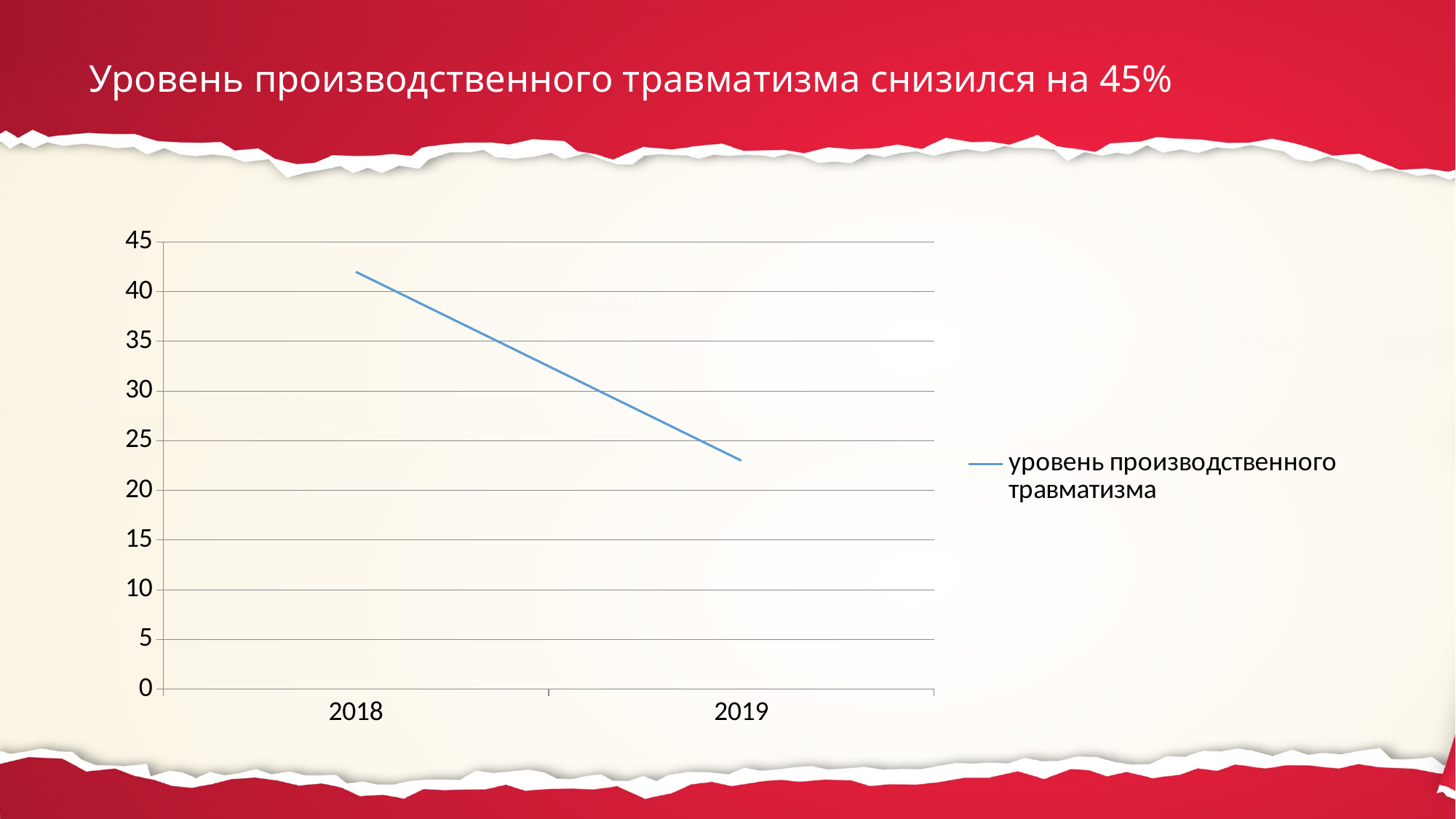
What is the name of the series shown in the legend? уровень производственного травматизма Which year has the highest value on the chart? 2018 Is the value for 2019 greater or less than 30? less What kind of chart is shown on the slide? line chart Do the values rise or fall from 2018 to 2019? fall Which year has the lowest value on the chart? 2019 How many data points are plotted on the chart? 2 What is the title of the slide? Уровень производственного травматизма снизился на 45% Which is larger, the value for 2018 or the value for 2019? 2018 Is the value for 2019 greater or less than 15? greater How many series does the legend list? 1 Is the value for 2018 greater or less than 35? greater